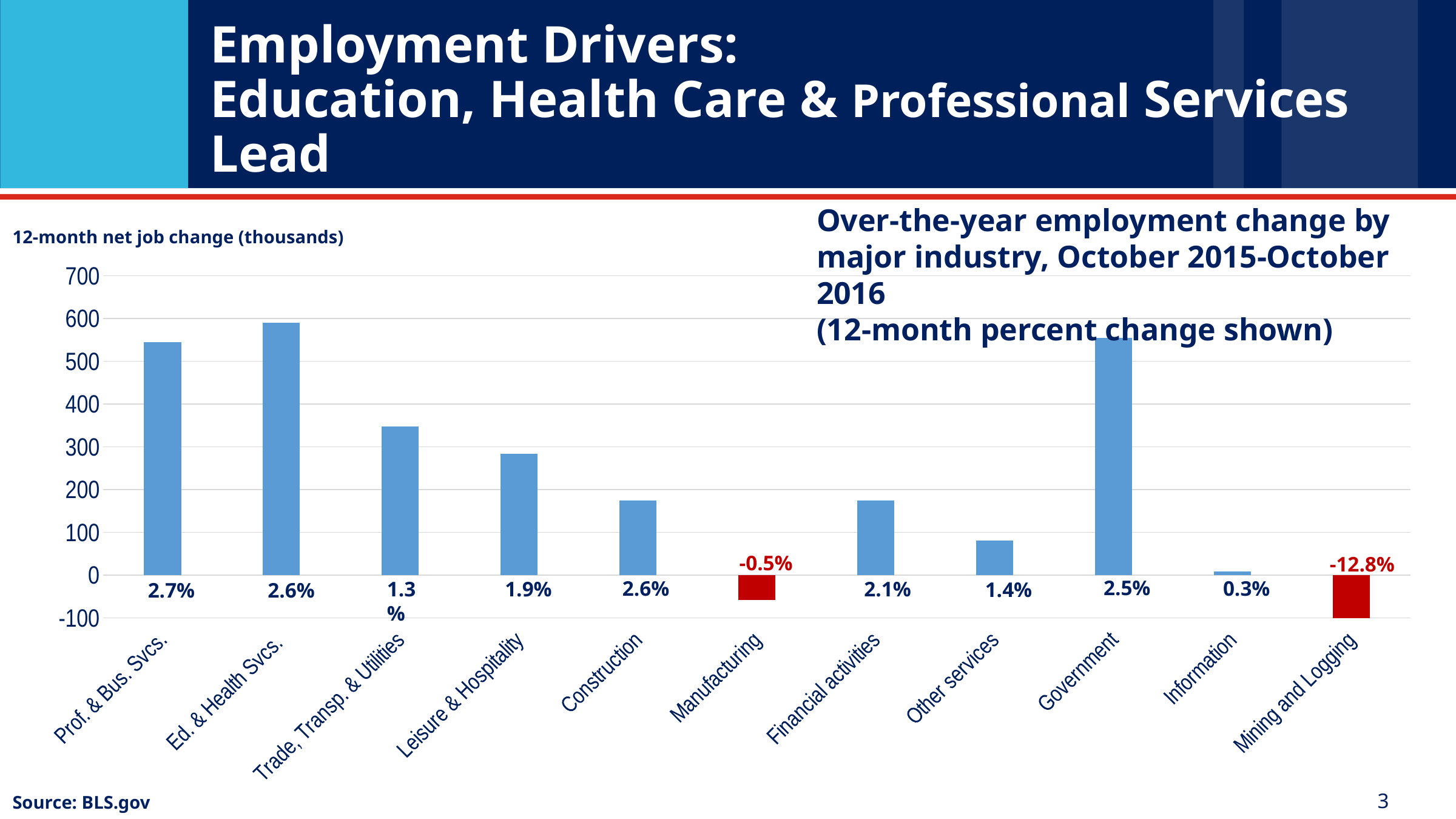
What 12-month percent change is shown for Government? 2.5% What 12-month percent change is shown for Mining and Logging? -12.8% How many industries are shown on the chart? 11 Is the net job change bar for Trade, Transp. & Utilities greater or less than 300? greater Which has the larger net job change bar, Leisure & Hospitality or Construction? Leisure & Hospitality Which industry has the tallest bar for 12-month net job change? Ed. & Health Svcs. Is the net job change bar for Other services greater or less than 100? less What kind of chart is shown on the slide? bar chart What 12-month percent change is shown for Manufacturing? -0.5% What is the difference between the percent change labels for Prof. & Bus. Svcs. and Trade, Transp. & Utilities? 1.4 percentage points Which industry has the lowest bar for 12-month net job change? Mining and Logging What is the label above the vertical axis of the chart? 12-month net job change (thousands)